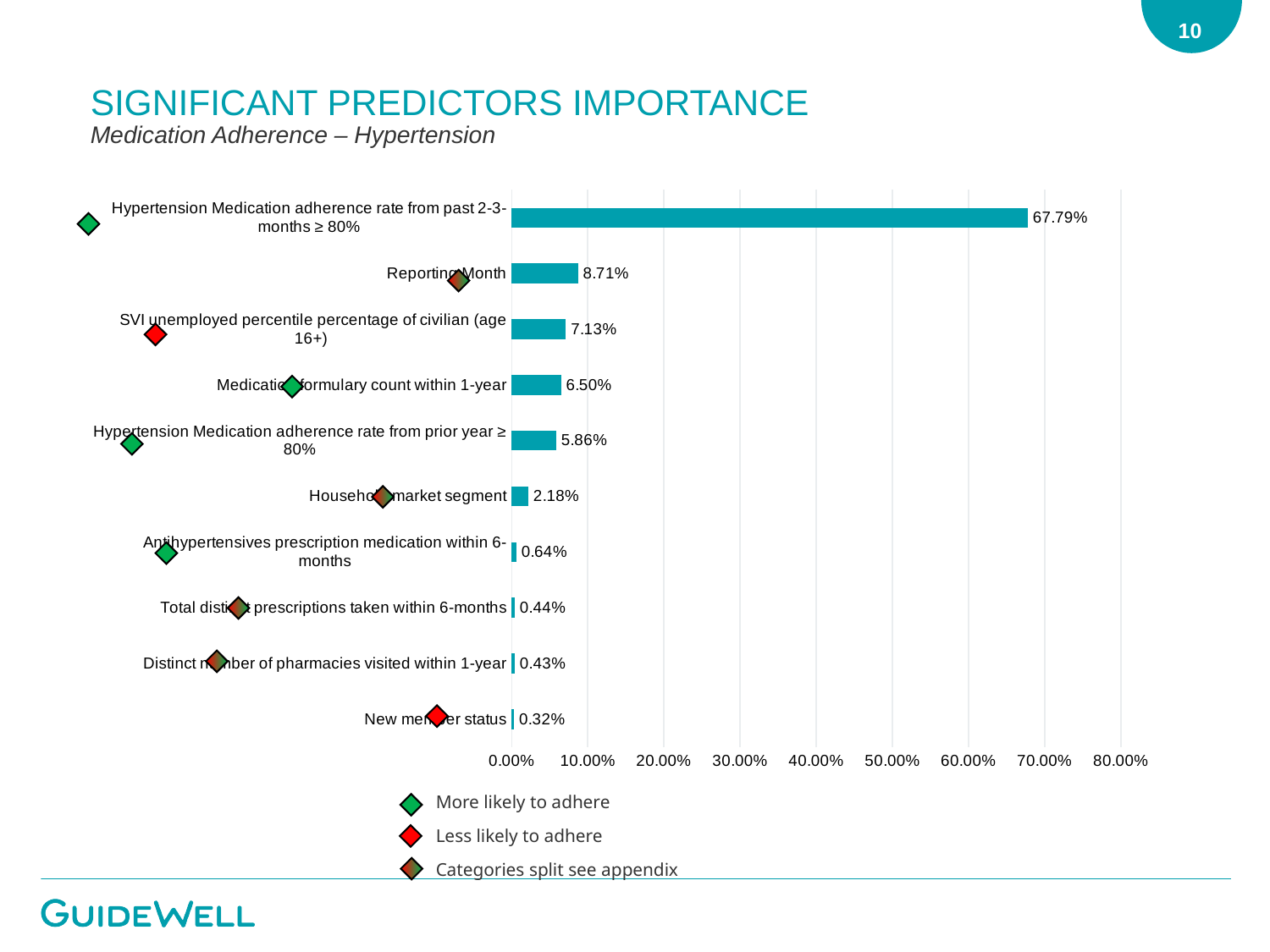
What is the importance value for Household market segment? 2.18% What does a red diamond marker indicate according to the legend? Less likely to adhere What is the importance value for Reporting Month? 8.71% Is the value for Hypertension Medication adherence rate from past 2-3-months ≥ 80% greater or less than 60.00%? greater Which predictor has the lowest importance? New member status Which predictor has the highest importance? Hypertension Medication adherence rate from past 2-3-months ≥ 80% What is the importance value for Medication formulary count within 1-year? 6.50% What is the importance value for Antihypertensives prescription medication within 6-months? 0.64% What kind of chart is shown on the slide? Bar chart How many predictors are shown in the chart? 10 Which has a higher importance value: Medication formulary count within 1-year or Hypertension Medication adherence rate from prior year ≥ 80%? Medication formulary count within 1-year What is the difference between the importance of Reporting Month and SVI unemployed percentile percentage of civilian (age 16+)? 1.58%